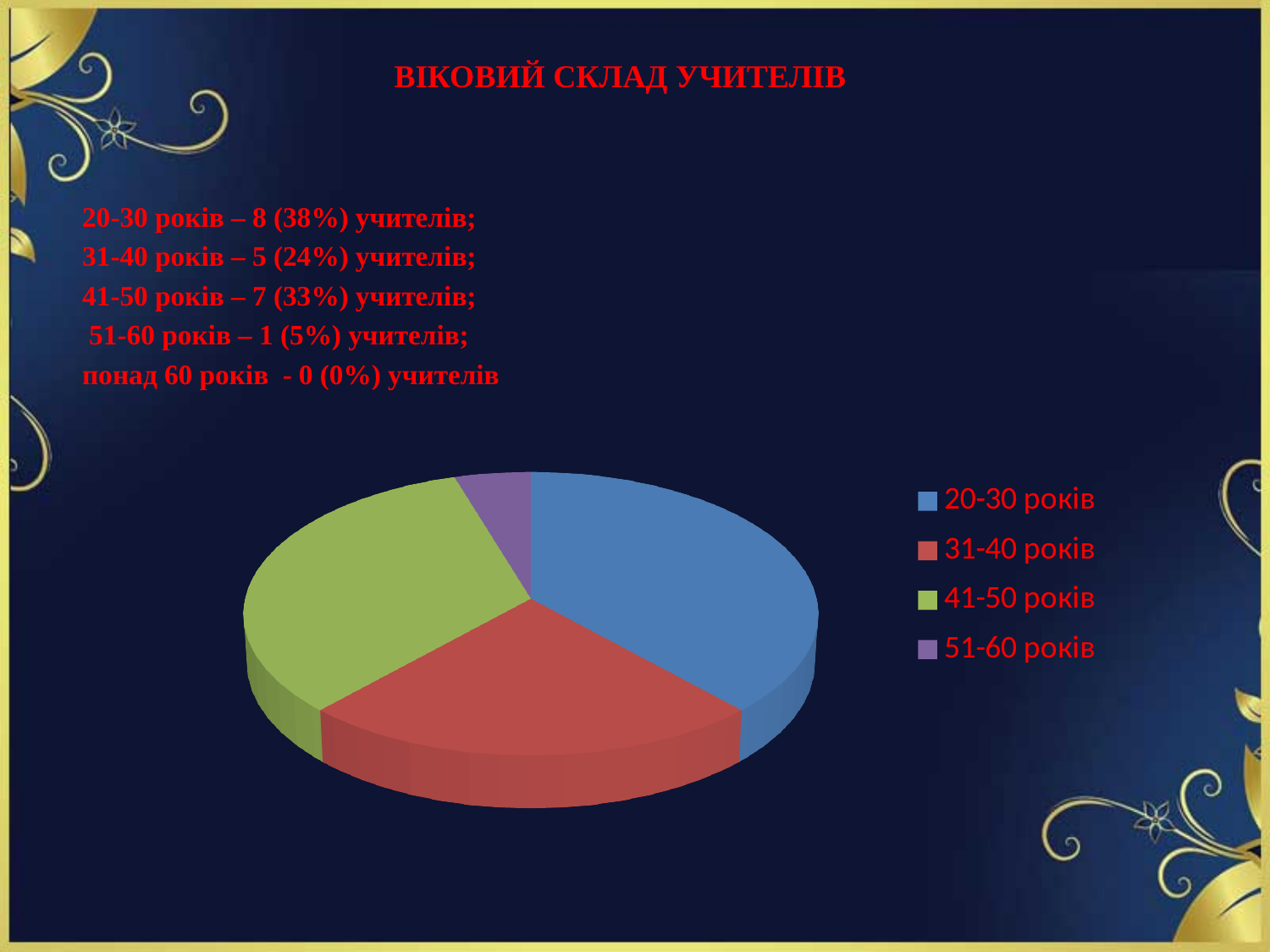
What is the title of the slide with the pie chart? ВІКОВИЙ СКЛАД УЧИТЕЛІВ According to the slide, how many teachers are aged 51-60 років? 1 What colour is the slice for 41-50 років in the pie chart? green According to the slide, how many teachers are aged 31-40 років? 5 According to the slide, what share of teachers are aged 41-50 років? 33% Which age group has the largest slice of the pie chart? 20-30 років How many categories does the legend of the pie chart list? 4 What kind of chart is shown on the slide? pie chart According to the slide, what share of teachers are aged 20-30 років? 38% Which slice is larger in the pie chart: 20-30 років or 51-60 років? 20-30 років Which age group has the smallest slice of the pie chart? 51-60 років Which slice is larger in the pie chart: 41-50 років or 31-40 років? 41-50 років